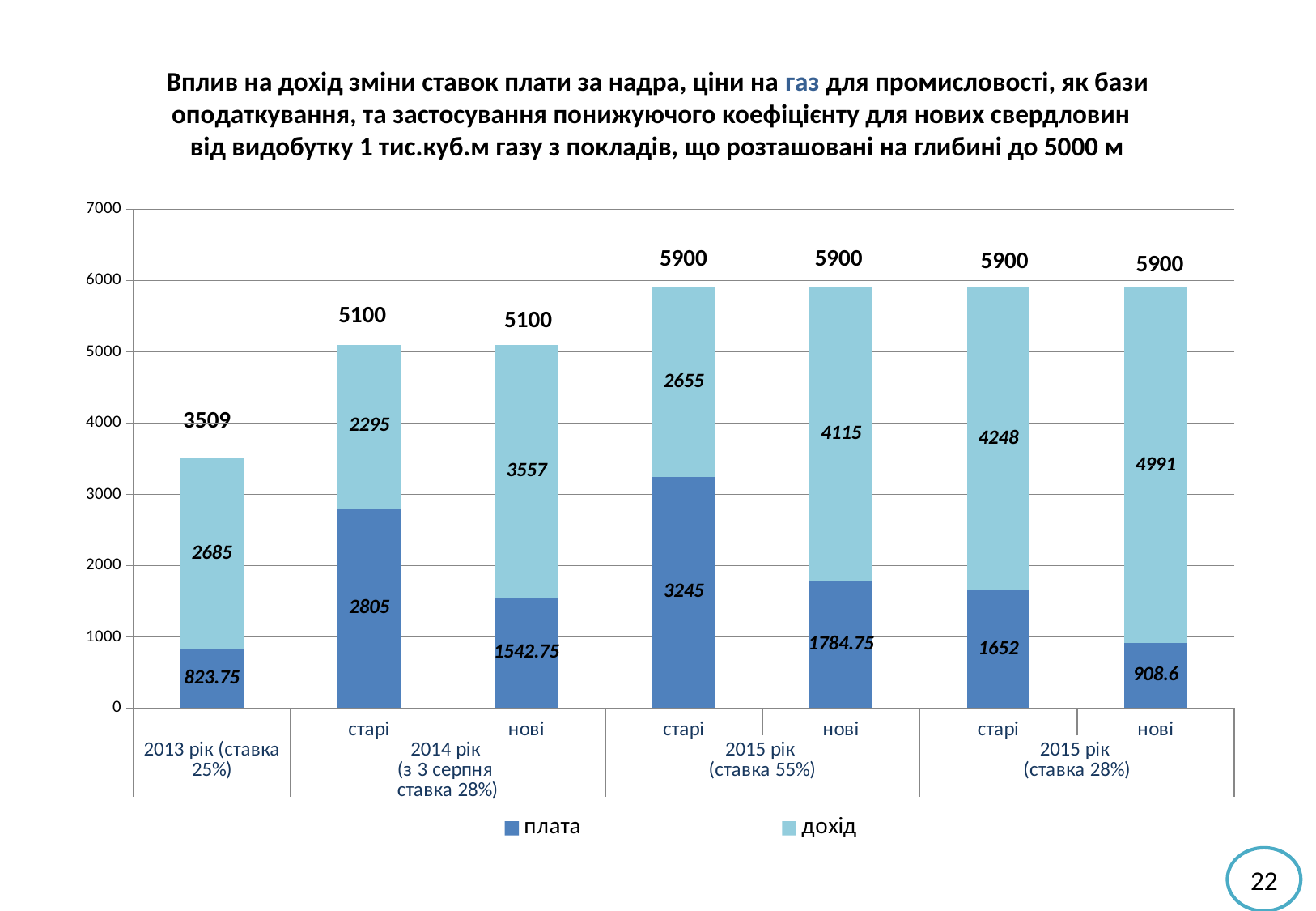
What is the difference between дохід for нові and старі wells in 2015 рік (ставка 28%)? 743 How many bars are plotted in the chart? 7 Which is larger: плата for старі wells in 2014 рік or плата for нові wells in 2015 рік (ставка 55%)? старі wells in 2014 рік What is the value of плата for старі wells in 2015 рік (ставка 55%)? 3245 What is the value of плата for 2013 рік (ставка 25%)? 823.75 What is the value of дохід for нові wells in 2015 рік (ставка 28%)? 4991 Which bar has the lowest дохід value? старі, 2014 рік (з 3 серпня ставка 28%) How many series does the legend list? 2 Which series is shown in the darker blue colour? плата Which bar has the highest плата value? старі, 2015 рік (ставка 55%) What is the total of the stacked bar for 2013 рік (ставка 25%)? 3509 What kind of chart is shown on the slide? stacked bar chart